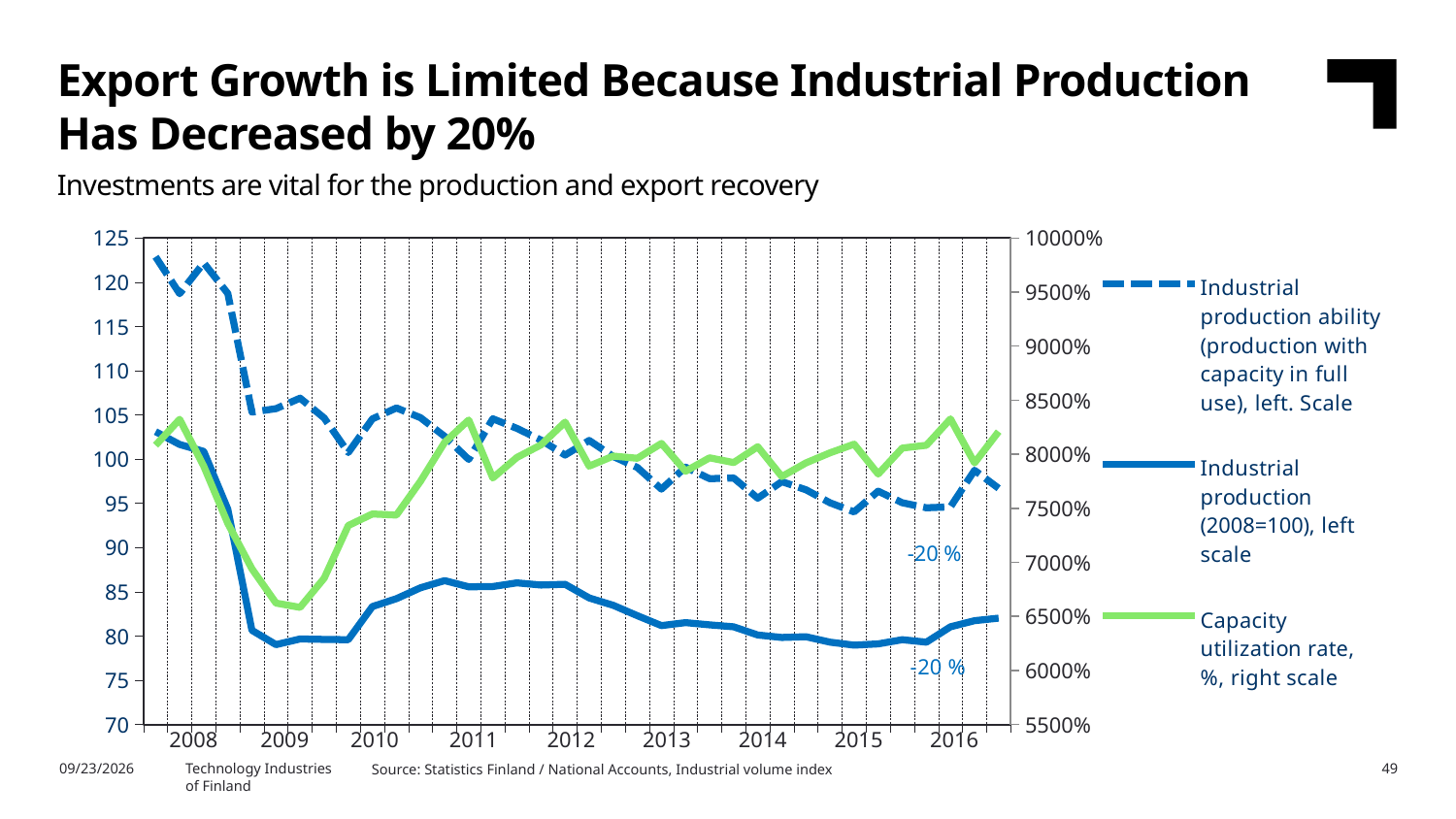
Is the value for Industrial production ability at the start of 2008 greater or less than 120? greater What kind of chart is shown on the slide? line chart Is the value for Industrial production ability at the end of 2016 greater or less than 100? less Which series has the lowest value on the left scale in 2009? Industrial production (2008=100) Which series is plotted on the right scale? Capacity utilization rate, % Does the Industrial production (2008=100) line rise or fall between 2008 and 2009? fall How many series does the legend list? 3 In 2009, which is higher on the left scale: Industrial production ability or Industrial production (2008=100)? Industrial production ability What annotation label is printed next to the blue lines near 2015–2016? -20 % How many year labels are shown on the x axis? 9 Does the Industrial production ability line rise or fall overall from 2008 to 2016? fall Is the value for Industrial production (2008=100) in 2016 greater or less than 85? less